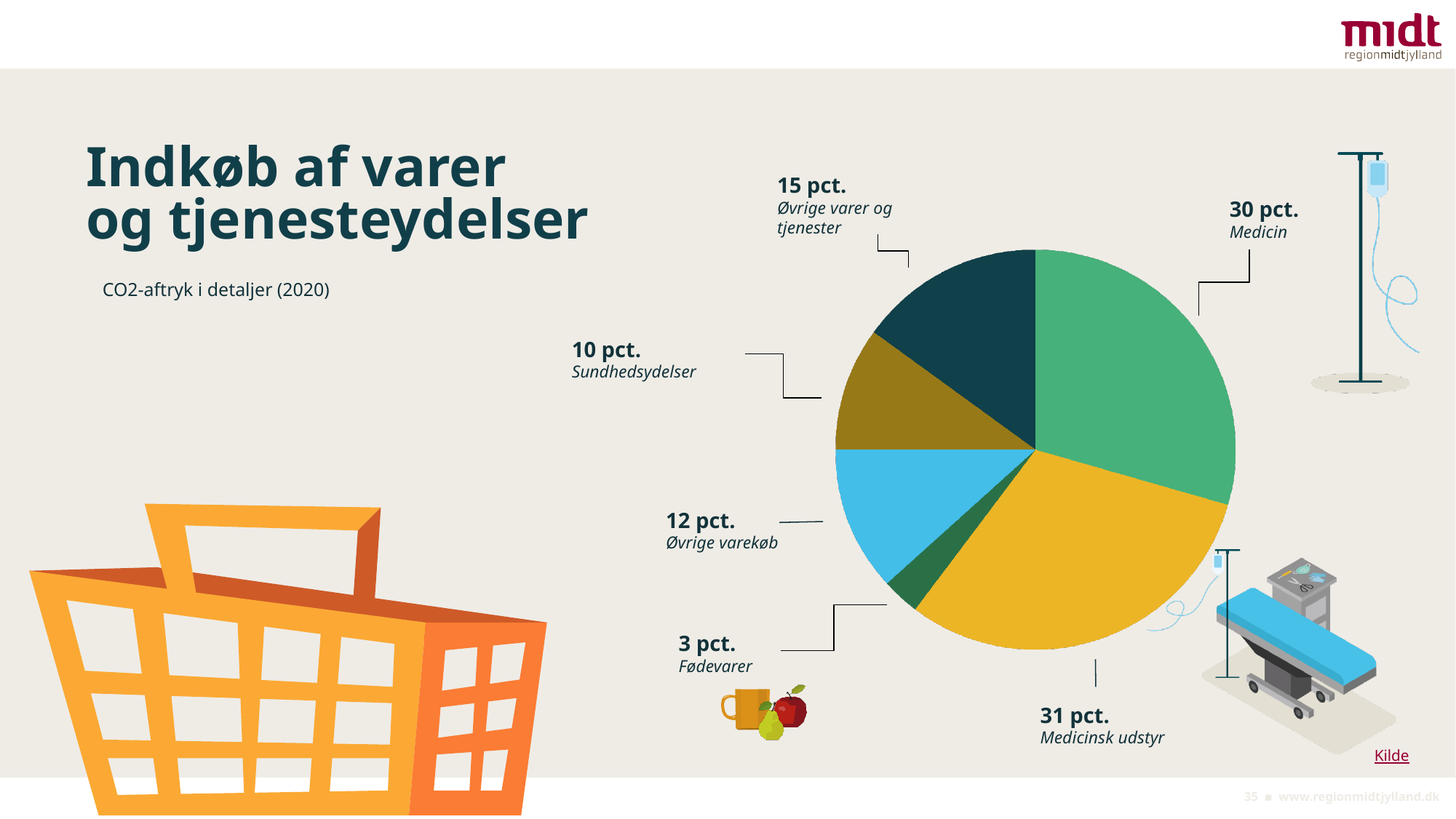
What kind of chart is shown on the slide? Pie chart What share of the pie chart is Fødevarer? 3 pct. Which category has the smallest slice of the pie chart? Fødevarer Which category has the largest slice of the pie chart? Medicinsk udstyr What share of the pie chart is Øvrige varekøb? 12 pct. What share of the pie chart is Øvrige varer og tjenester? 15 pct. What share of the pie chart is Medicinsk udstyr? 31 pct. What share of the pie chart is Sundhedsydelser? 10 pct. What share of the pie chart is Medicin? 30 pct. What is the difference in percentage points between Øvrige varer og tjenester and Sundhedsydelser? 5 pct. Which is larger, the share for Øvrige varekøb or the share for Sundhedsydelser? Øvrige varekøb How many categories are shown in the pie chart? 6